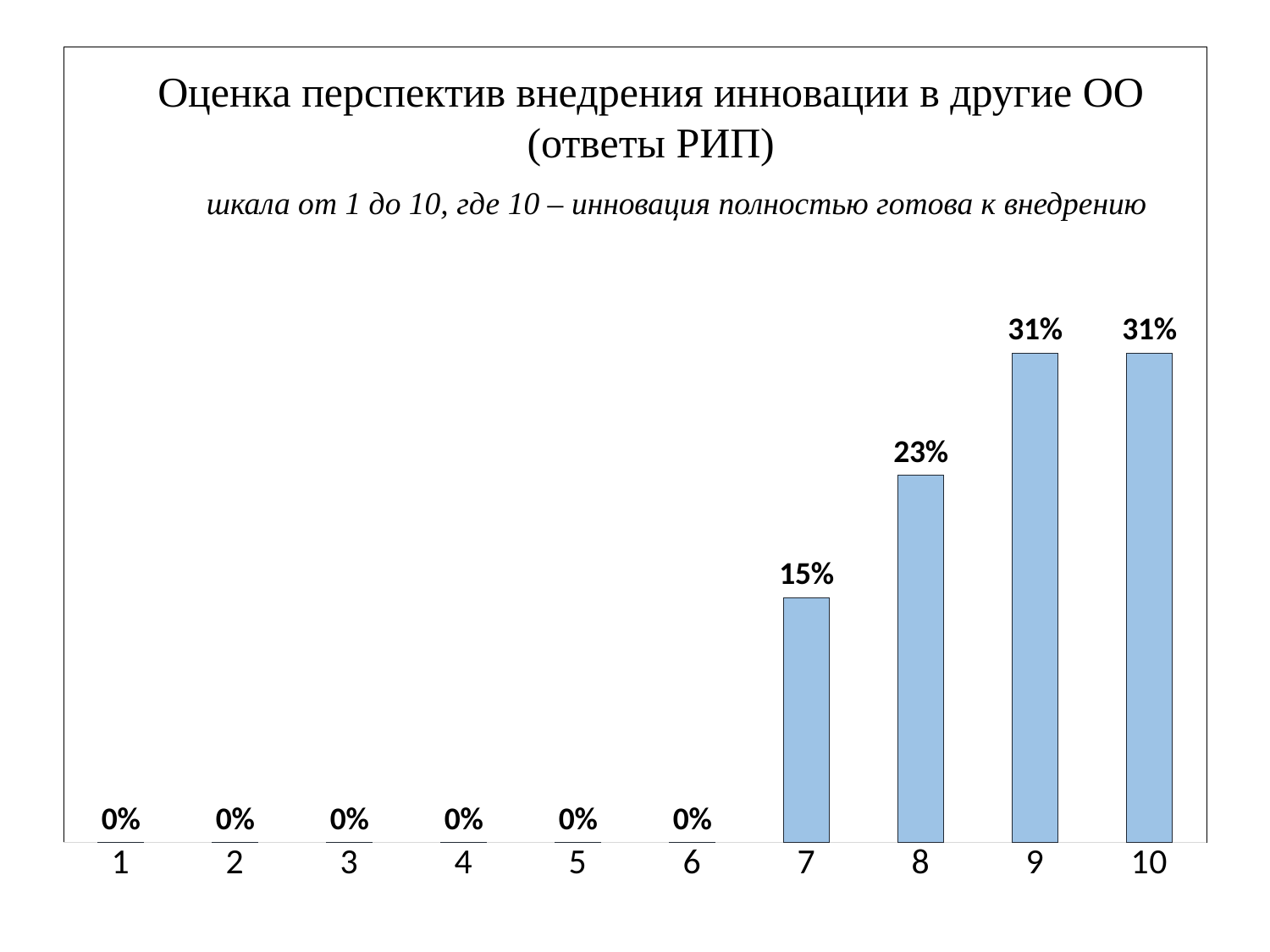
What is the value for category 10? 31% What is the value for category 3? 0% Which is larger, the value for category 7 or the value for category 8? 8 How many categories are shown on the x axis? 10 What kind of chart is shown on the slide? bar chart What is the value for category 7? 15% What is the difference between the values for categories 8 and 7? 8% How many categories have a value of 0%? 6 What is the value for category 8? 23% Which category has the lowest non-zero value? 7 What is the difference between the values for categories 9 and 8? 8% Do the values rise or fall from category 7 to category 9? rise